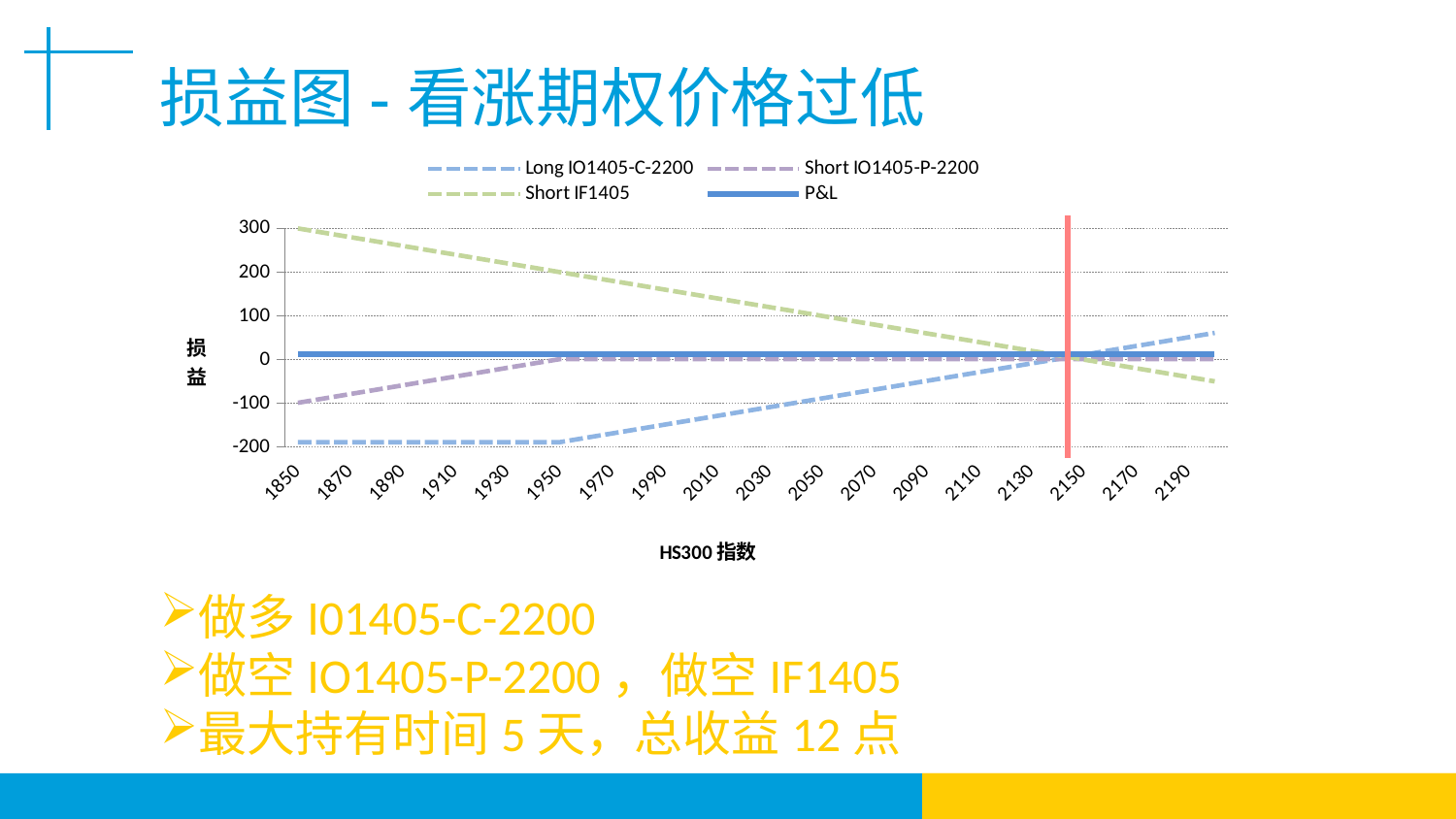
Does the Long IO1405-C-2200 line rise or fall overall as the HS300 index increases from 1950 to 2190? rise What is the value of Short IF1405 at an HS300 index of 1850? 300 How many series does the legend list? 4 Is the value of Long IO1405-C-2200 at an HS300 index of 1850 greater or less than -100? less What kind of chart is shown on the slide? line chart What is the title of the x axis of the chart? HS300 指数 How many x-axis tick labels (HS300 index values) are shown on the chart? 18 At an HS300 index of 1850, which series has the lowest value? Long IO1405-C-2200 Is the value of Short IF1405 at an HS300 index of 2190 greater or less than 0? less Does the Short IF1405 line rise or fall as the HS300 index increases? fall At an HS300 index of 1850, which series has the highest value? Short IF1405